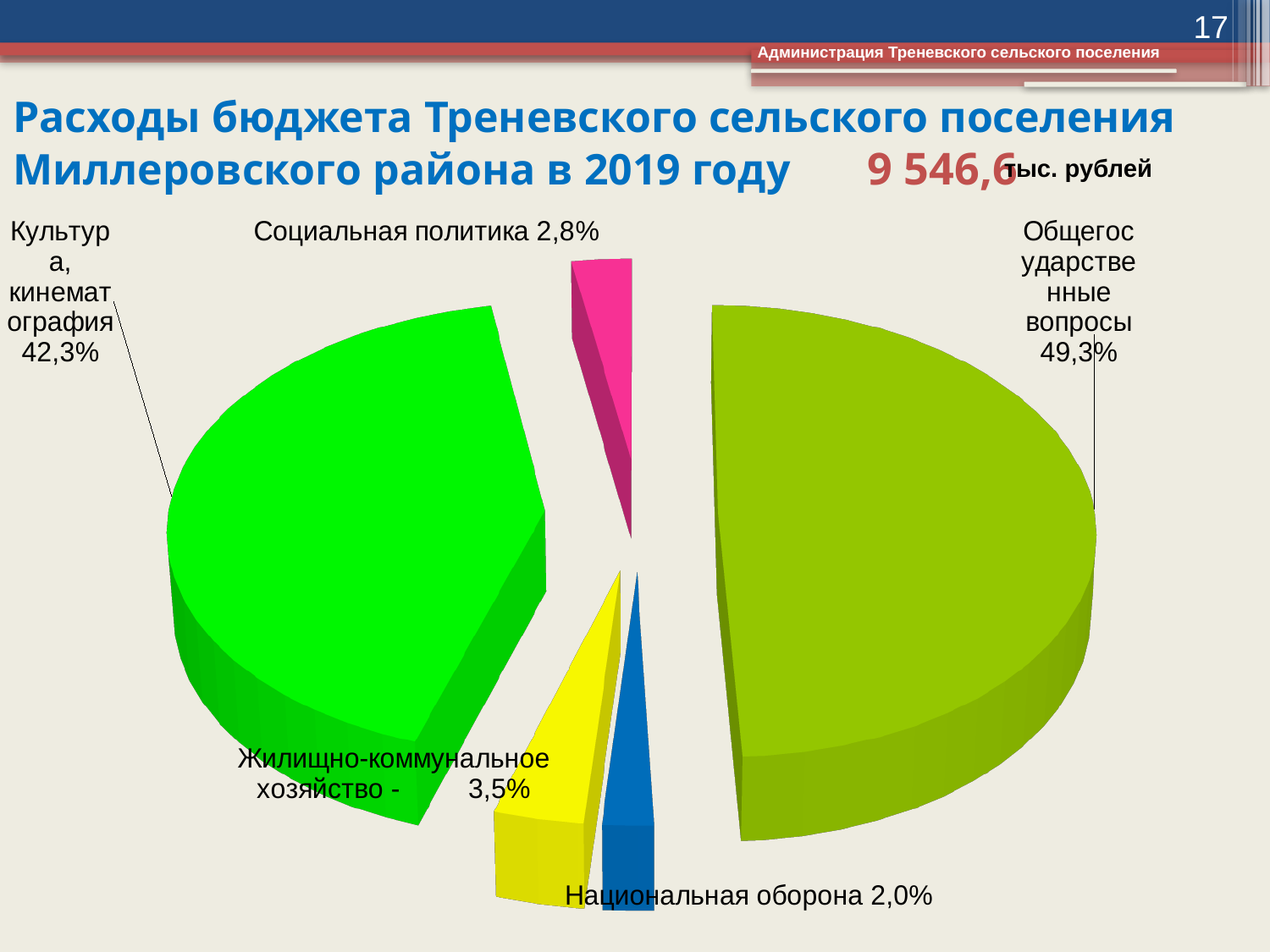
What share of the budget expenditure goes to Национальная оборона? 2,0% What share of the budget expenditure goes to Социальная политика? 2,8% Which category has the smallest share of the pie? Национальная оборона Which is larger: the share for Жилищно-коммунальное хозяйство or the share for Социальная политика? Жилищно-коммунальное хозяйство Which category has the largest share of the pie? Общегосударственные вопросы What share of the budget expenditure goes to Общегосударственные вопросы? 49,3% What is the difference in percentage points between Общегосударственные вопросы and Культура, кинематография? 7,0 How many slices does the pie chart have? 5 What share of the budget expenditure goes to Культура, кинематография? 42,3% What share of the budget expenditure goes to Жилищно-коммунальное хозяйство? 3,5% What total budget expenditure amount is stated in the slide title? 9 546,6 тыс. рублей What kind of chart is shown on the slide? Pie chart